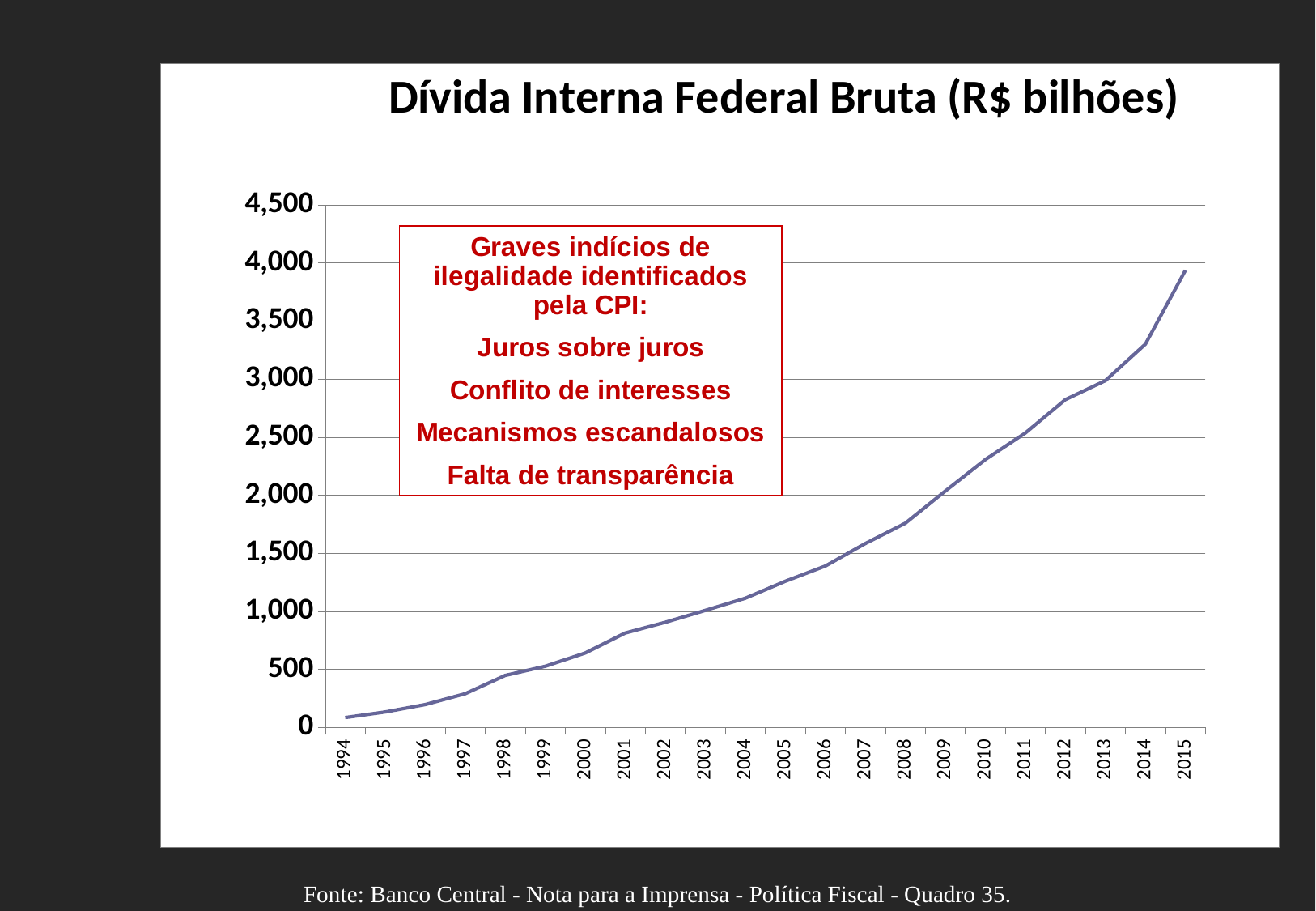
Is the value for 2008 greater or less than 1,500? greater Is the value for 2015 greater or less than 3,500? greater Is the value for 1994 greater or less than 500? less Which year has the lowest value? 1994 Which year has the highest value? 2015 What kind of chart is shown on the slide? line chart How many years are plotted along the x axis? 22 Which is larger, the value for 2010 or the value for 2005? 2010 Do the values rise or fall from 1994 to 2015? rise What is the title of the chart? Dívida Interna Federal Bruta (R$ bilhões)